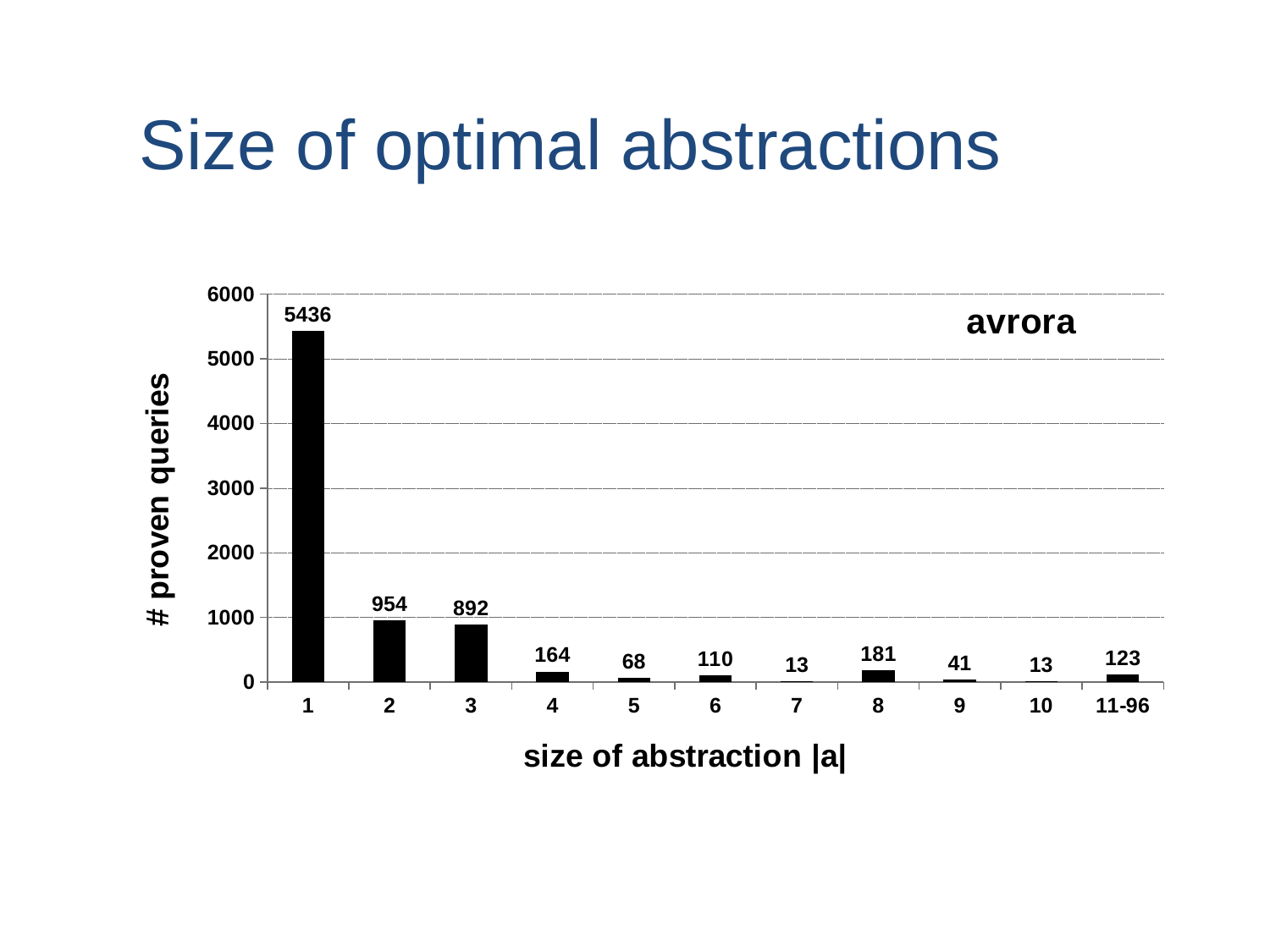
Which abstraction size has the highest number of proven queries? 1 Which has more proven queries: abstraction size 4 or abstraction size 6? 4 What is the total number of proven queries for abstraction sizes 7 and 10 combined? 26 What kind of chart is shown on the slide? bar chart How many abstraction-size categories are shown on the x axis? 11 What is the difference in proven queries between abstraction size 2 and abstraction size 3? 62 What is the number of proven queries for abstraction size 11-96? 123 What benchmark name is printed inside the chart area? avrora What is the number of proven queries for abstraction size 8? 181 How many proven queries have an optimal abstraction of size 1? 5436 Is the value for abstraction size 1 greater or less than 5000? greater What is the label on the y axis of the chart? # proven queries